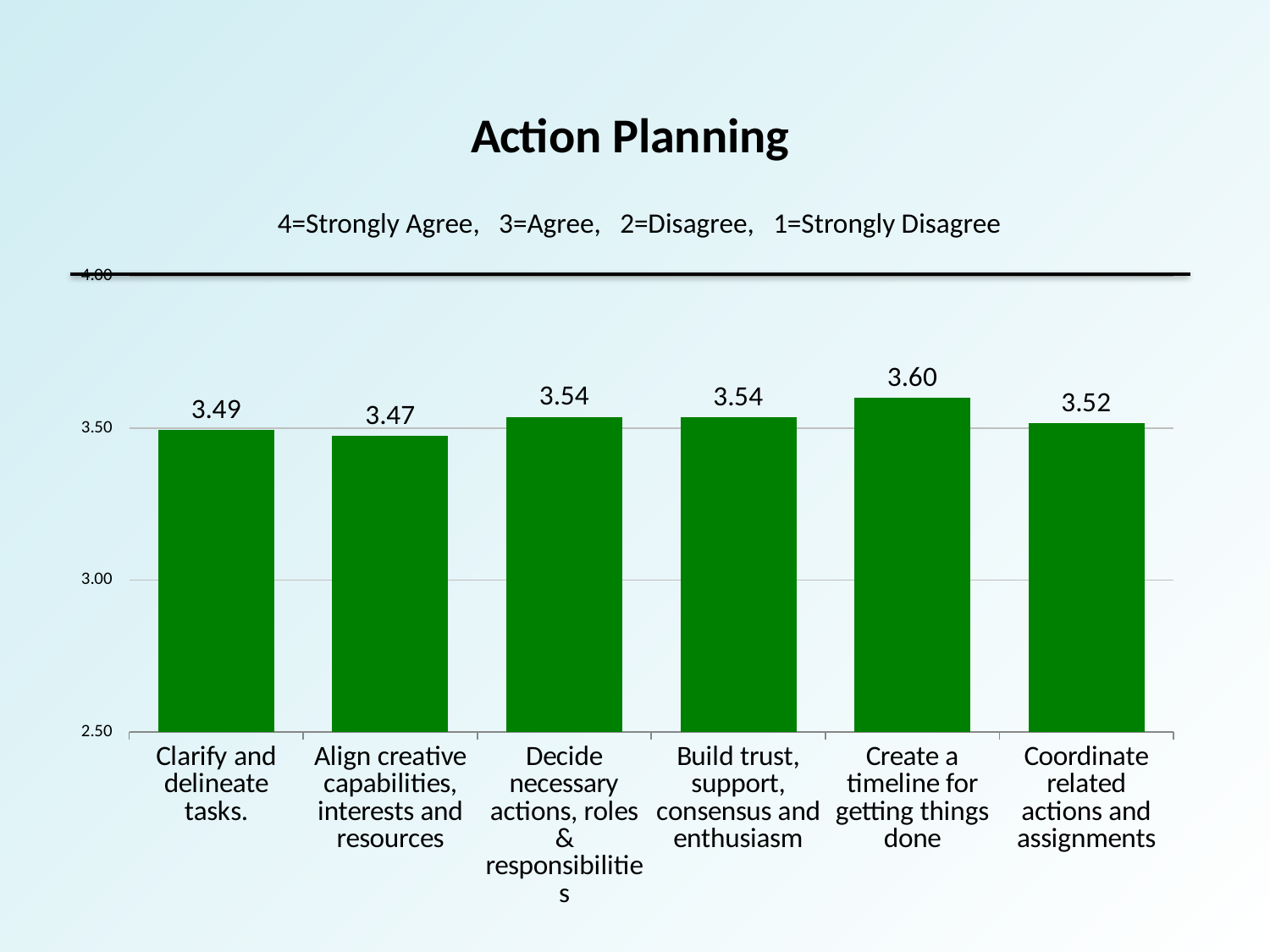
Which category has the highest value? Create a timeline for getting things done What kind of chart is shown on the slide? Bar chart What is the value for "Align creative capabilities, interests and resources"? 3.47 What is the title of the chart? Action Planning What is the value for "Clarify and delineate tasks."? 3.49 How many categories are shown in the chart? 6 What is the value for "Coordinate related actions and assignments"? 3.52 Which category has the lowest value? Align creative capabilities, interests and resources Is the value for "Build trust, support, consensus and enthusiasm" greater or less than 3.50? greater What is the value for "Create a timeline for getting things done"? 3.60 What is the difference between the values for "Create a timeline for getting things done" and "Align creative capabilities, interests and resources"? 0.13 Which is larger, the value for "Coordinate related actions and assignments" or the value for "Clarify and delineate tasks."? Coordinate related actions and assignments